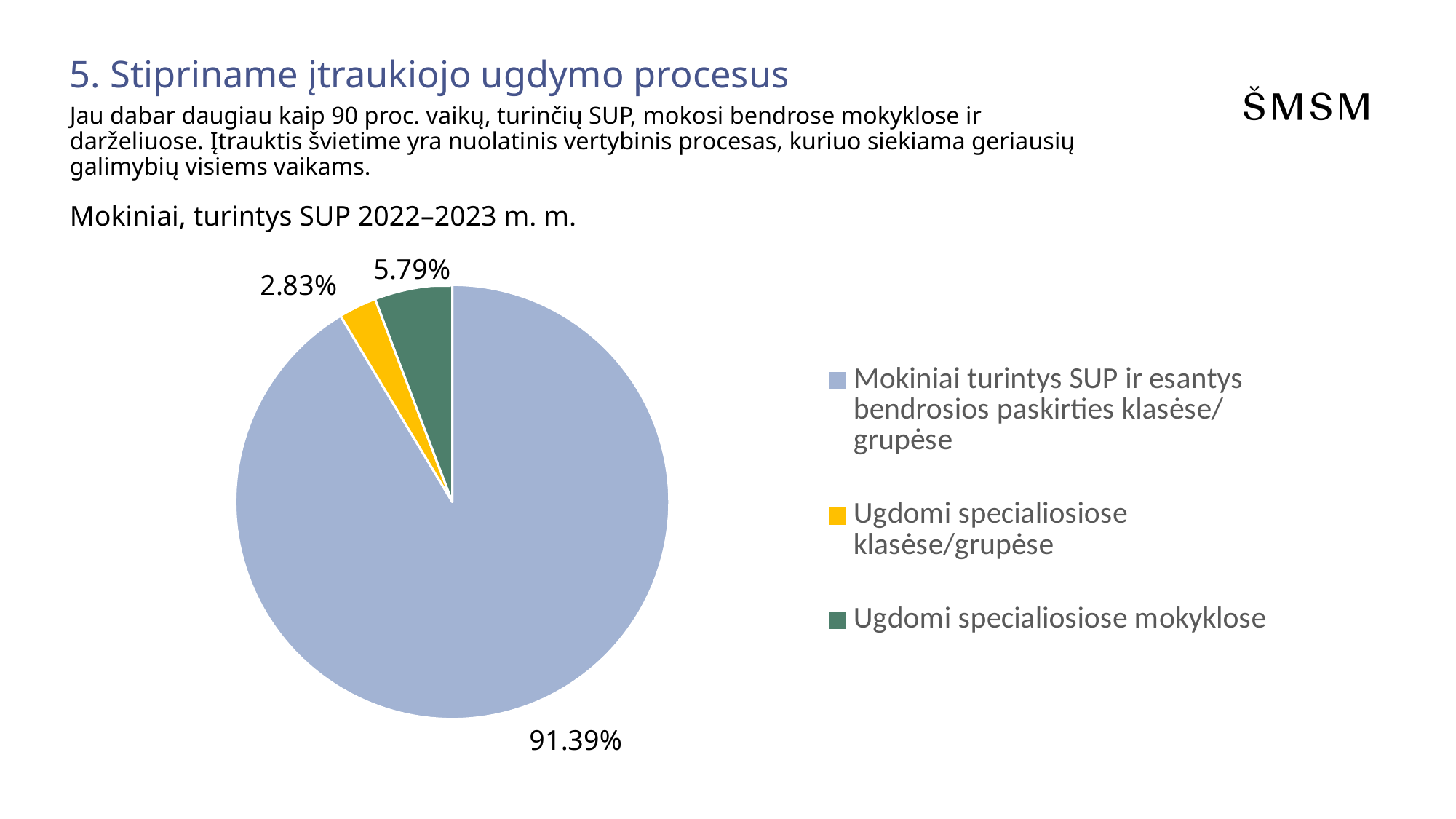
What share of the pie is 'Ugdomi specialiosiose mokyklose'? 5.79% How many slices does the pie chart have? 3 Which category has the largest slice of the pie? Mokiniai turintys SUP ir esantys bendrosios paskirties klasėse/grupėse What share of the pie is 'Mokiniai turintys SUP ir esantys bendrosios paskirties klasėse/grupėse'? 91.39% What type of chart is shown on the slide? Pie chart Which category has the smallest slice of the pie? Ugdomi specialiosiose klasėse/grupėse Which is larger: 'Ugdomi specialiosiose mokyklose' or 'Ugdomi specialiosiose klasėse/grupėse'? Ugdomi specialiosiose mokyklose What is the difference between the shares of 'Ugdomi specialiosiose mokyklose' and 'Ugdomi specialiosiose klasėse/grupėse'? 2.96% What colour is the slice for 'Ugdomi specialiosiose klasėse/grupėse'? Yellow What is the title of the chart? Mokiniai, turintys SUP 2022–2023 m. m. What share of the pie is 'Ugdomi specialiosiose klasėse/grupėse'? 2.83% How many entries does the legend list? 3